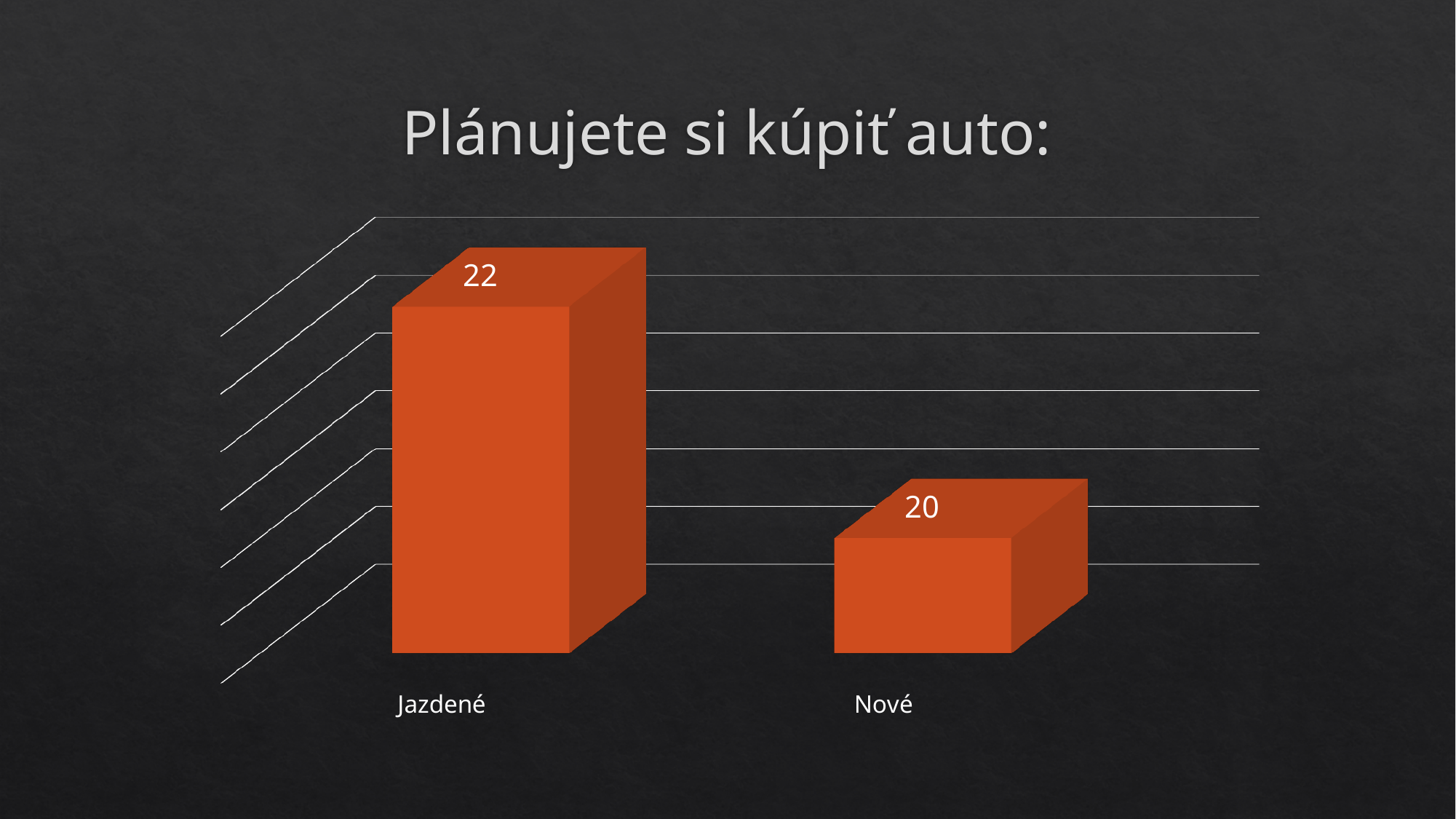
Which is larger, the value for Jazdené or the value for Nové? Jazdené Which category has the highest value? Jazdené Which category has the lowest value? Nové What is the value for Nové? 20 Do the values rise or fall from left to right across the categories? Fall What colour are the bars in the chart? Orange How many categories are shown in the chart? 2 What kind of chart is shown on the slide? Bar chart What is the difference between the values for Jazdené and Nové? 2 What is the title of the slide? Plánujete si kúpiť auto: What is the value for Jazdené? 22